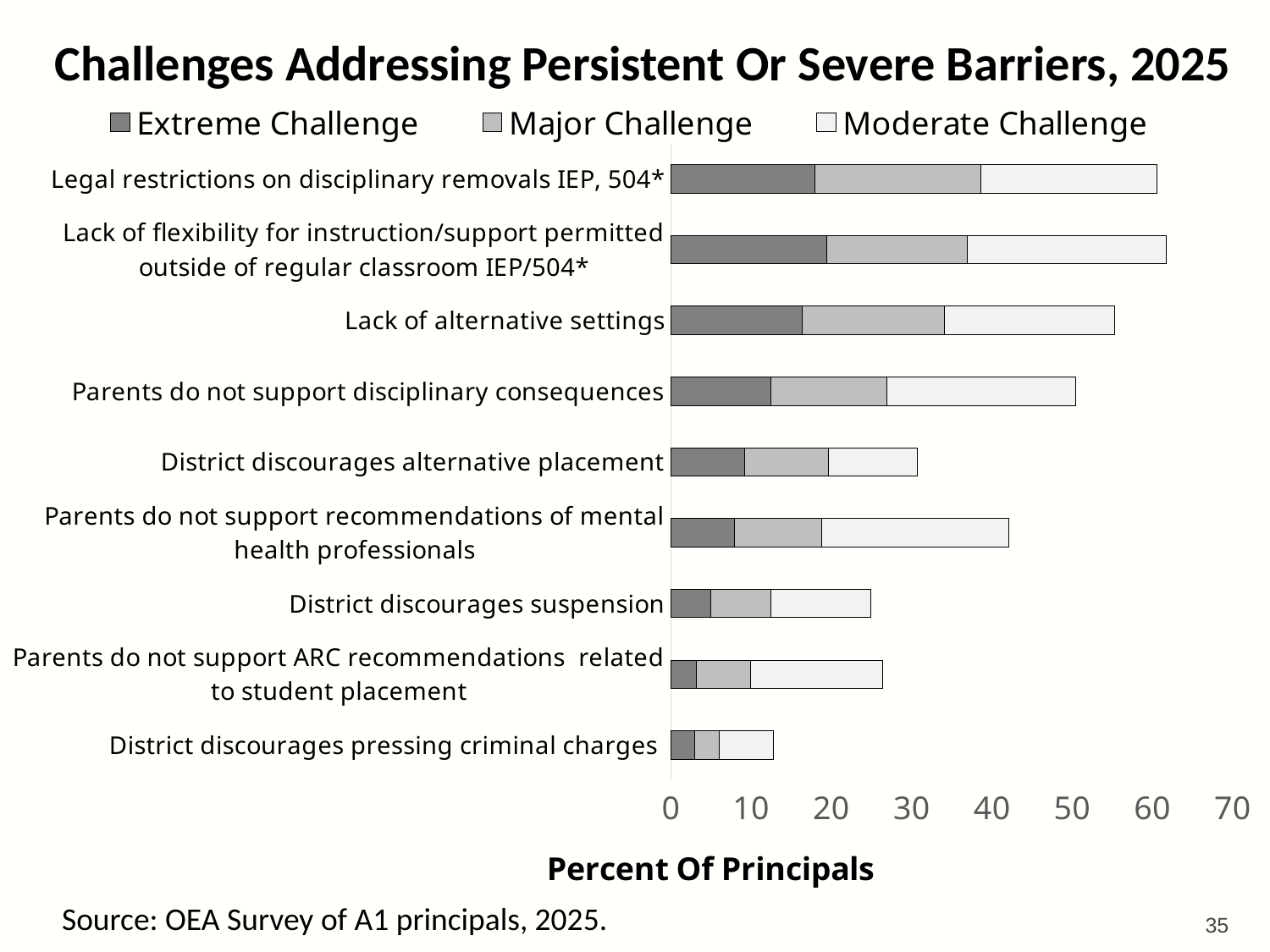
Is the total bar for 'Lack of alternative settings' greater or less than 50? greater Is the total bar for 'District discourages suspension' greater or less than 30? less What kind of chart is shown on the slide? Stacked bar chart Is the total bar for 'Legal restrictions on disciplinary removals IEP, 504*' greater or less than 50? greater What is the title of the chart? Challenges Addressing Persistent Or Severe Barriers, 2025 Which category has the shortest total bar? District discourages pressing criminal charges Which has the longer total bar: 'District discourages alternative placement' or 'Parents do not support recommendations of mental health professionals'? Parents do not support recommendations of mental health professionals How many challenge categories are plotted on the chart? 9 What is the label of the horizontal axis? Percent Of Principals Which has the longer total bar: 'Lack of alternative settings' or 'Parents do not support disciplinary consequences'? Lack of alternative settings How many series does the legend list? 3